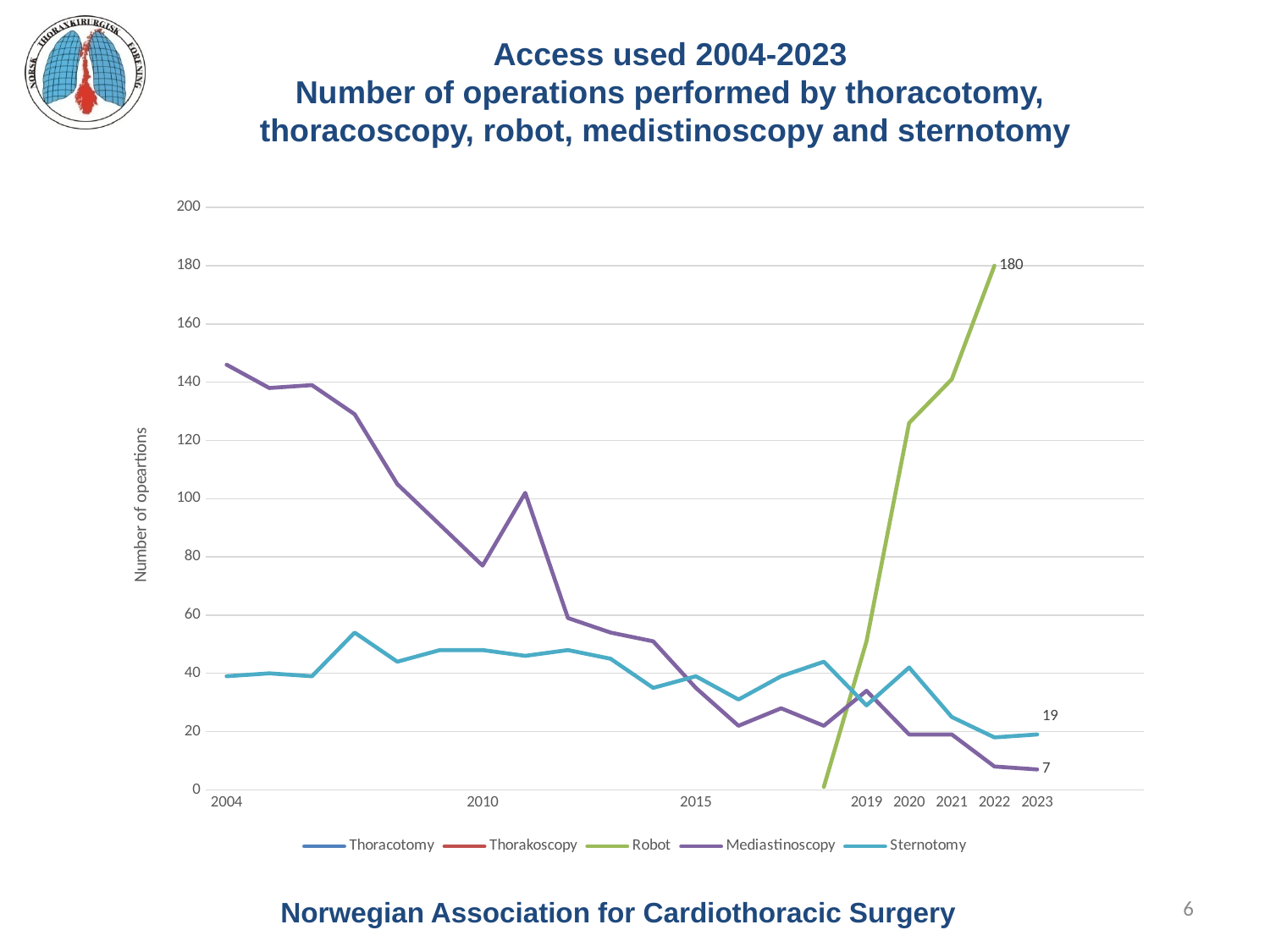
What kind of chart is shown on the slide? line chart What is the value for Mediastinoscopy in 2023? 7 What is the labelled value at the end of the Robot line? 180 Is the value for Sternotomy in 2004 greater or less than 60? less What colour is the Robot line in the legend? green What is the difference between the Sternotomy and Mediastinoscopy values in 2023? 12 What is the value for Sternotomy in 2023? 19 Does the Mediastinoscopy line rise or fall overall from 2004 to 2023? fall In 2023, which is larger: Sternotomy or Mediastinoscopy? Sternotomy How many series does the legend list? 5 Is the value for Mediastinoscopy in 2004 greater or less than 120? greater Which series has the highest value in 2022? Robot